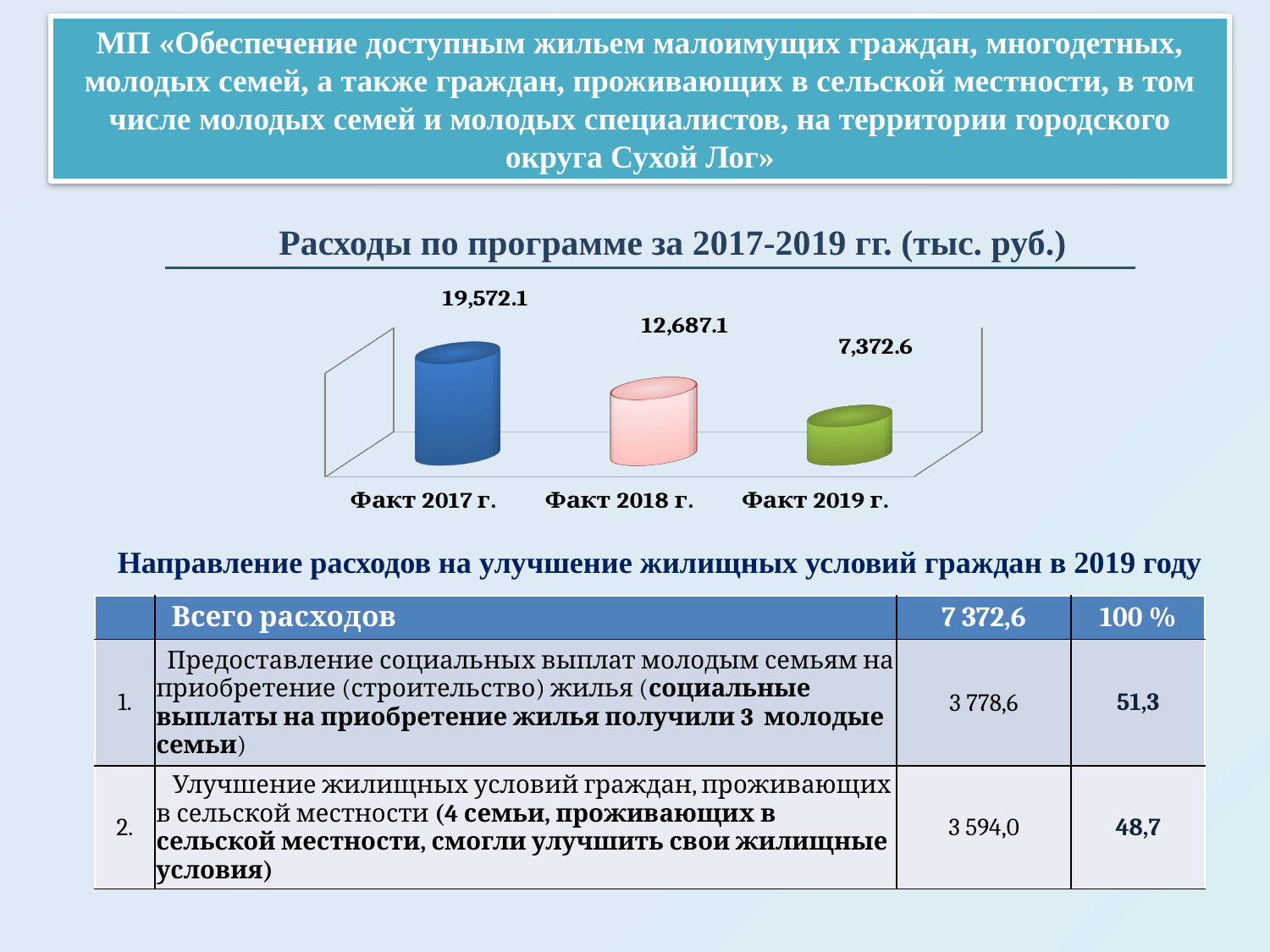
Which is larger, the value for Факт 2018 г. or the value for Факт 2019 г.? Факт 2018 г. Which category has the highest value in the chart? Факт 2017 г. What is the value for Факт 2019 г. in the chart? 7,372.6 What is the value for Факт 2018 г. in the chart? 12,687.1 Which category has the lowest value in the chart? Факт 2019 г. What kind of chart is shown on the slide? Bar chart What is the difference between the values for Факт 2018 г. and Факт 2019 г.? 5,314.5 What is the difference between the values for Факт 2017 г. and Факт 2018 г.? 6,885.0 What is the value for Факт 2017 г. in the chart? 19,572.1 How many categories are shown in the chart? 3 Do the values rise or fall from Факт 2017 г. to Факт 2019 г.? Fall What is the difference between the values for Факт 2017 г. and Факт 2019 г.? 12,199.5